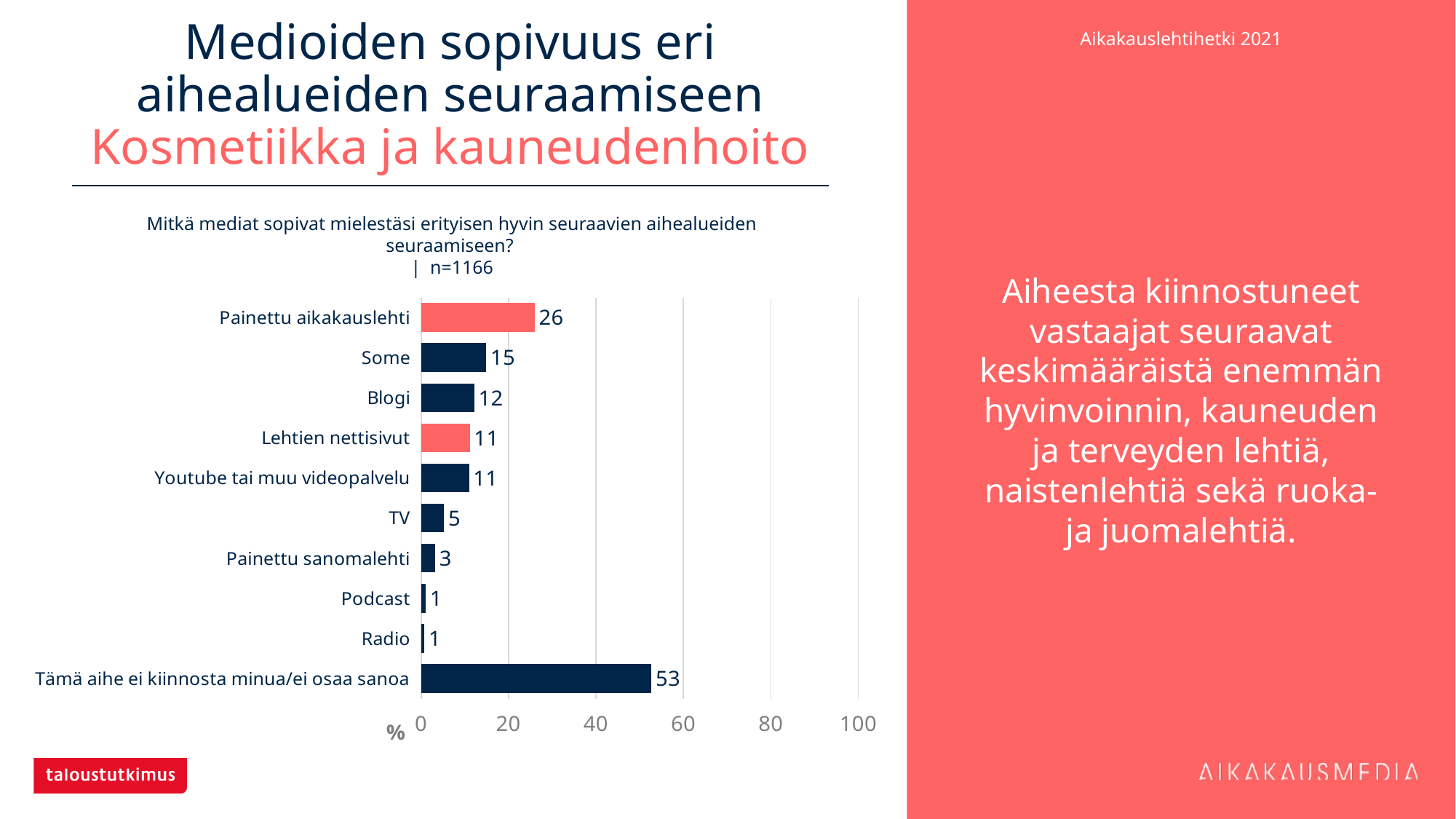
What is the value for Some? 15 Which is larger, the value for Blogi or the value for TV? Blogi How many categories are shown in the chart? 10 Is the value for Painettu aikakauslehti greater or less than 20? greater What is the value for Tämä aihe ei kiinnosta minua/ei osaa sanoa? 53 What is the sample size (n) stated in the chart subtitle? n=1166 Which category has the highest value? Tämä aihe ei kiinnosta minua/ei osaa sanoa What is the value for Painettu aikakauslehti? 26 What is the value for TV? 5 Which media category has the highest value, excluding the 'Tämä aihe ei kiinnosta minua/ei osaa sanoa' bar? Painettu aikakauslehti What kind of chart is shown on the slide? Bar chart What is the difference between the values for Painettu aikakauslehti and Some? 11